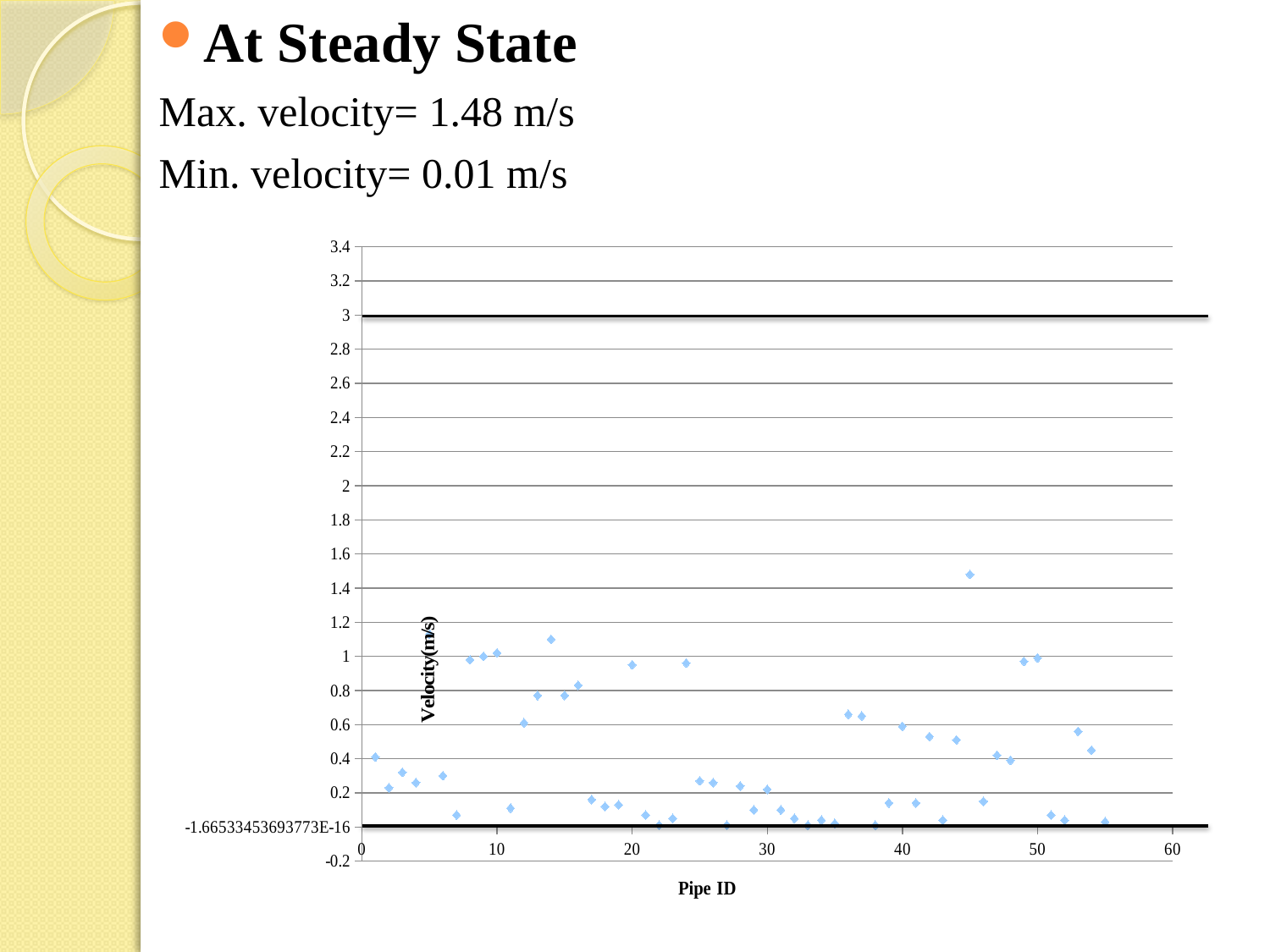
What kind of chart is shown on the slide? scatter chart What is the minimum velocity reported on the slide? 0.01 m/s Is the highest plotted velocity greater or less than 1.6? less Is the highest plotted point located at a Pipe ID greater or less than 40? greater What is the maximum velocity reported on the slide? 1.48 m/s At what y-axis value is the thick horizontal line near the top of the chart drawn? 3 Is the highest plotted velocity greater or less than 1.4? greater What is the largest tick value shown on the x axis? 60 What is the title of the y axis of the chart? Velocity(m/s) What is the title of the x axis of the chart? Pipe ID What is the largest tick value shown on the y axis? 3.4